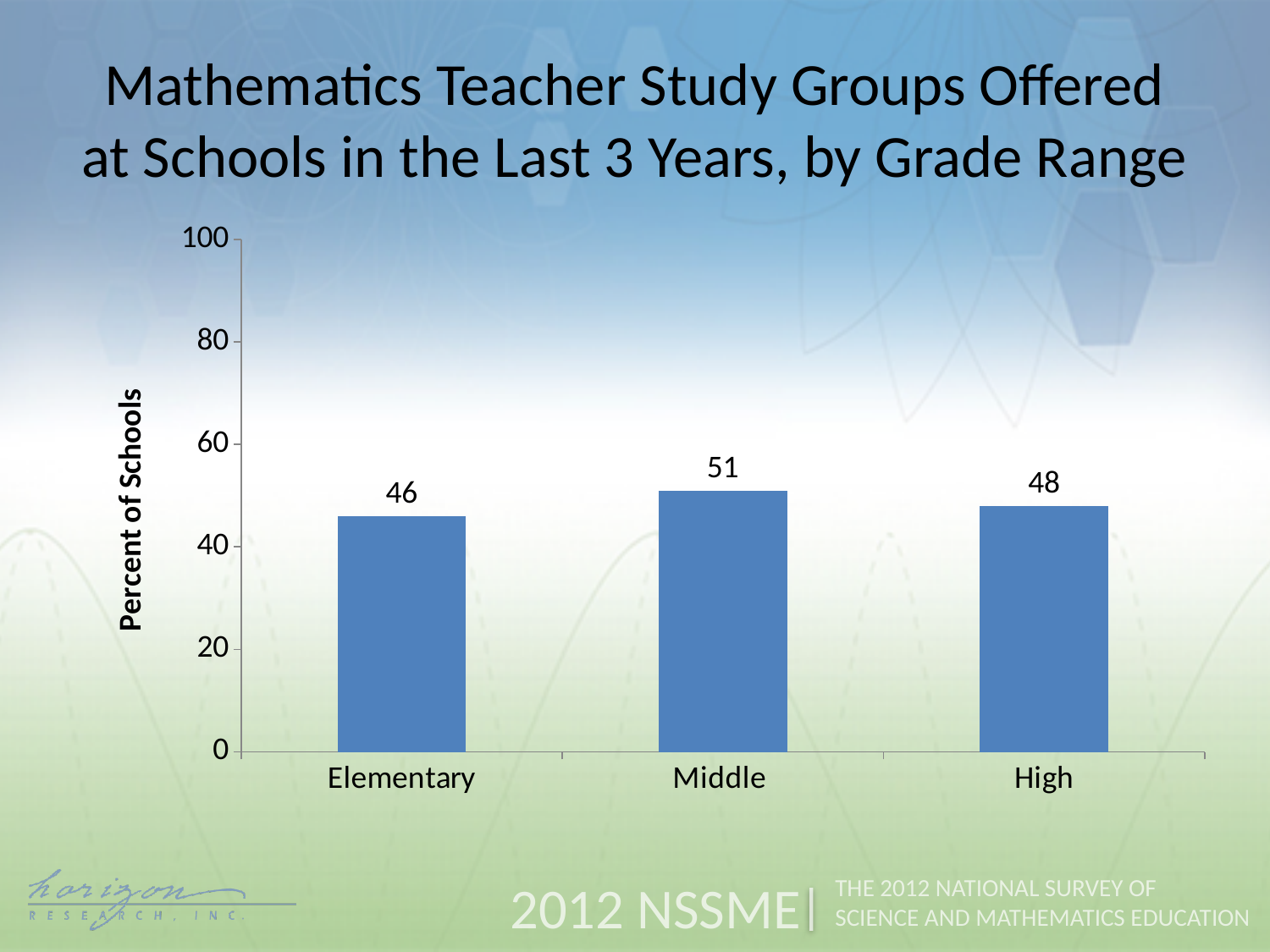
What percent of elementary schools offered mathematics teacher study groups in the last 3 years? 46 What kind of chart is shown on the slide? bar chart What is the difference between the values for High and Elementary schools? 2 What is the difference between the values for Middle and Elementary schools? 5 What is the label of the vertical axis? Percent of Schools What is the value shown for High schools? 48 Is the value for Elementary greater or less than 60? less Which is larger, the value for Middle or the value for High? Middle Which grade range has the highest percent of schools offering mathematics teacher study groups? Middle Which grade range has the lowest percent of schools offering mathematics teacher study groups? Elementary How many grade ranges are shown on the chart? 3 What is the value shown for Middle schools? 51